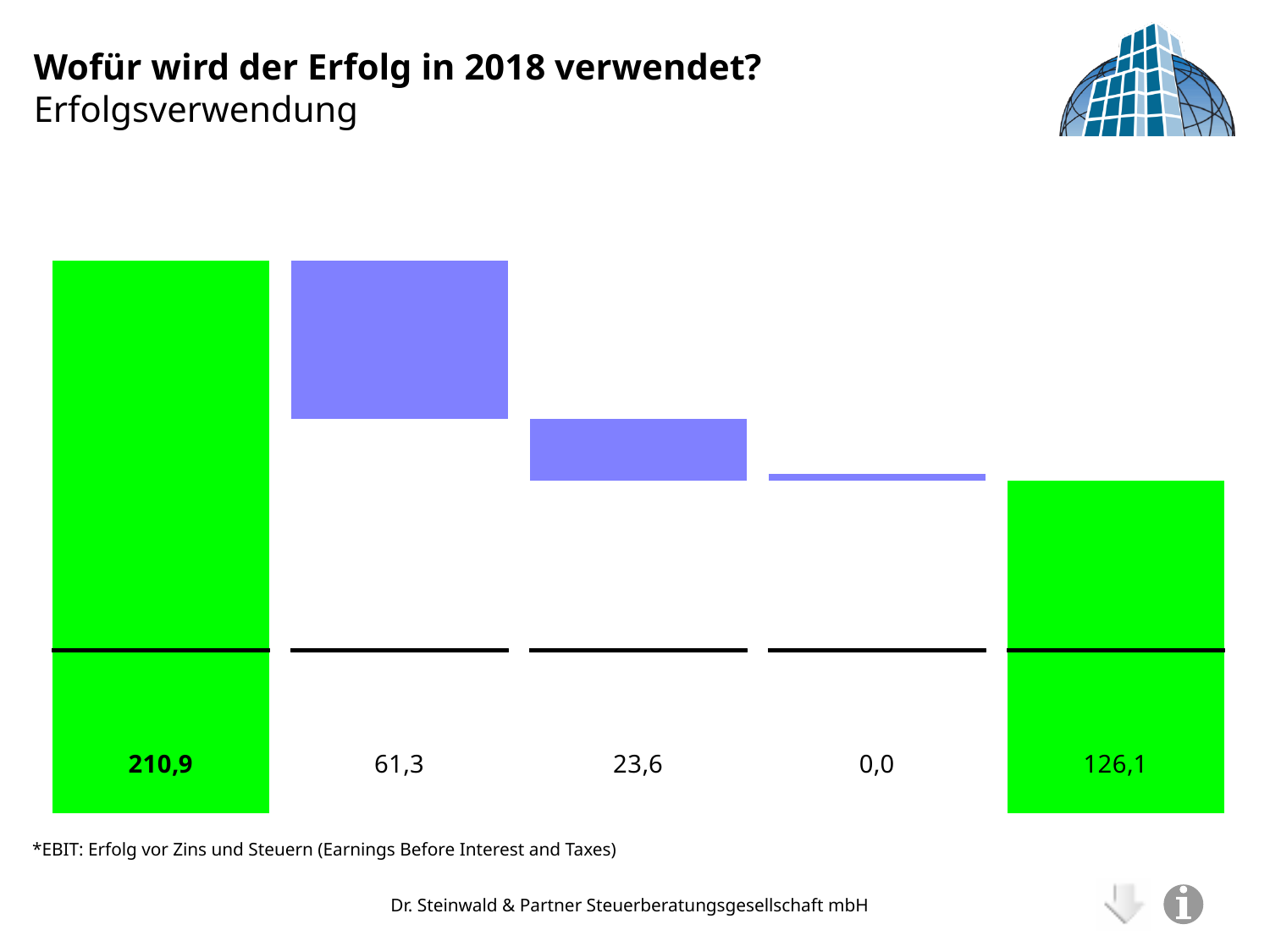
Which is larger, the value of the second bar or the value of the third bar? The second bar (61,3) What is the difference between the first bar (210,9) and the last bar (126,1)? 84,8 What is the difference between the second bar (61,3) and the third bar (23,6)? 37,7 What value is printed on the last (rightmost) bar of the chart? 126,1 Which bar has the lowest printed value? The fourth bar, 0,0 How many bars are shown in the chart? 5 Which bar has the highest printed value? The first (leftmost) bar, 210,9 What colour are the first and last bars of the chart? Green What value is printed on the second bar of the chart? 61,3 What value is printed on the third bar of the chart? 23,6 What value is printed on the fourth bar of the chart? 0,0 What value is printed on the first (leftmost) bar of the chart? 210,9